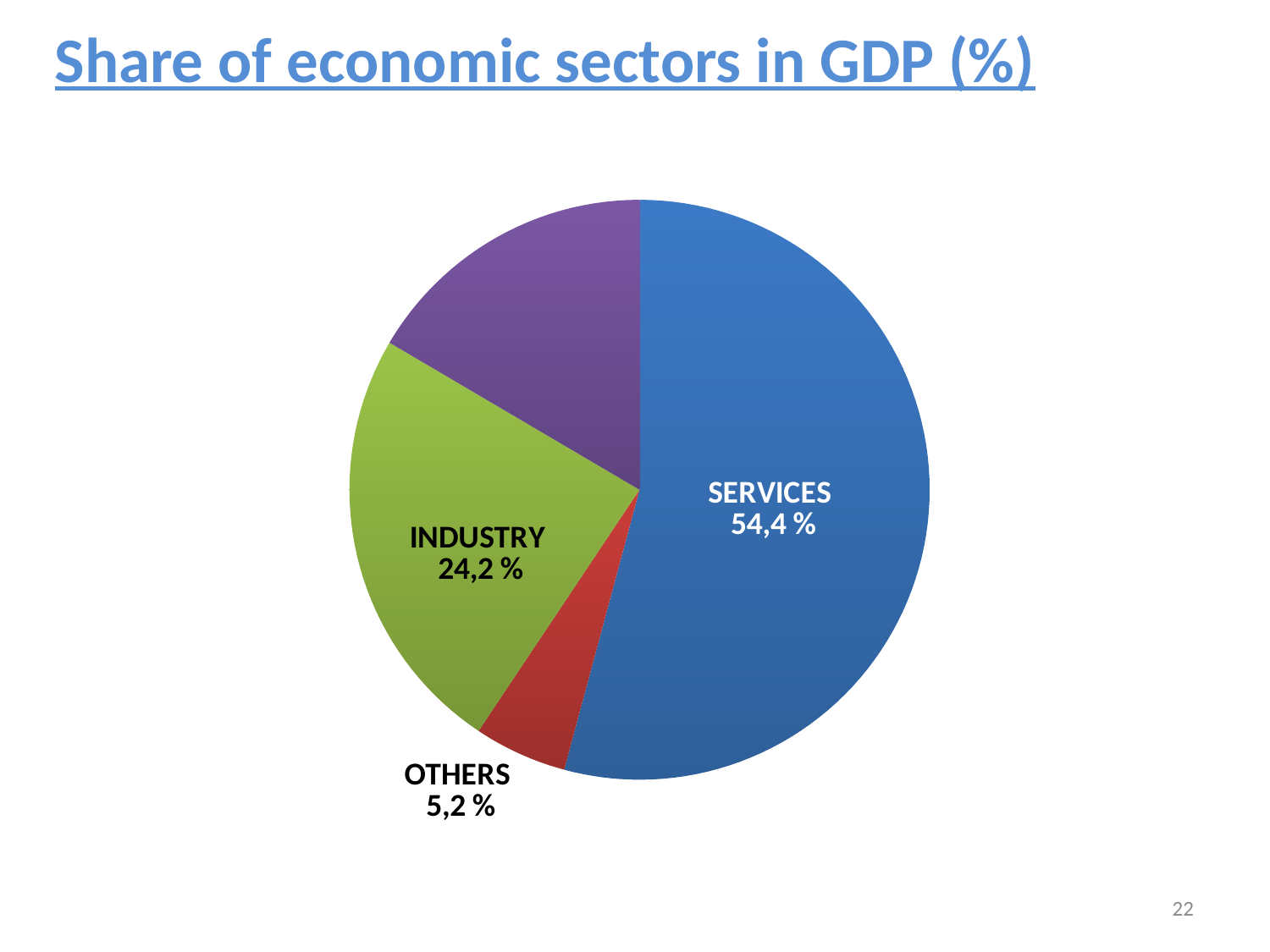
Which is larger, the share of INDUSTRY or the share of OTHERS? INDUSTRY What is the share of SERVICES in the pie chart? 54,4 % What is the title of the chart on the slide? Share of economic sectors in GDP (%) What is the share of INDUSTRY in the pie chart? 24,2 % What kind of chart is shown on the slide? pie chart How many slices does the pie chart have? 4 Which sector has the smallest slice in the pie chart? OTHERS Is the share of SERVICES greater or less than 50 %? greater What is the share of OTHERS in the pie chart? 5,2 % What is the difference between the INDUSTRY share and the OTHERS share? 19,0 % What is the difference between the SERVICES share and the INDUSTRY share? 30,2 % Which labelled sector has the largest share of GDP? SERVICES